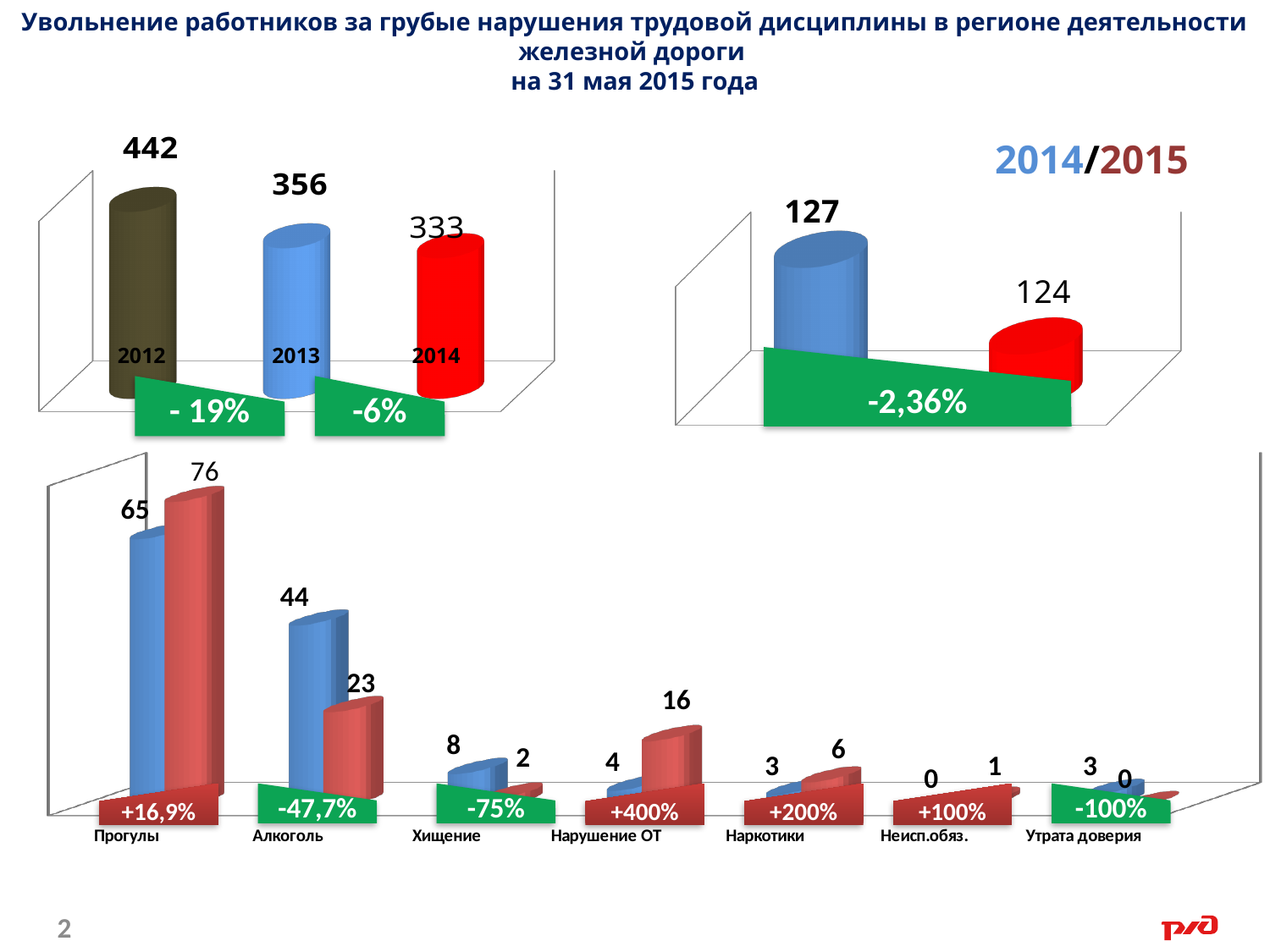
What kind of chart is the bottom chart? bar chart In the bottom chart, which is larger for Нарушение ОТ: the 2014 value or the 2015 value? 2015 In the top-left chart, which year has the highest value? 2012 In the top-left chart, what is the difference between the 2012 and 2013 values? 86 In the bottom chart, what is the 2015 (red) value for Прогулы? 76 In the top-right chart (2014/2015), what percentage change is shown on the green label? -2,36% In the bottom chart, what is the difference between the 2014 and 2015 values for Алкоголь? 21 In the top-right chart (2014/2015), what is the value for 2015 (red bar)? 124 In the bottom chart, how many categories are shown on the x axis? 7 In the top-left chart, what is the value for 2014? 333 In the bottom chart, what is the 2014 (blue) value for Алкоголь? 44 In the top-left chart, what is the value for 2012? 442